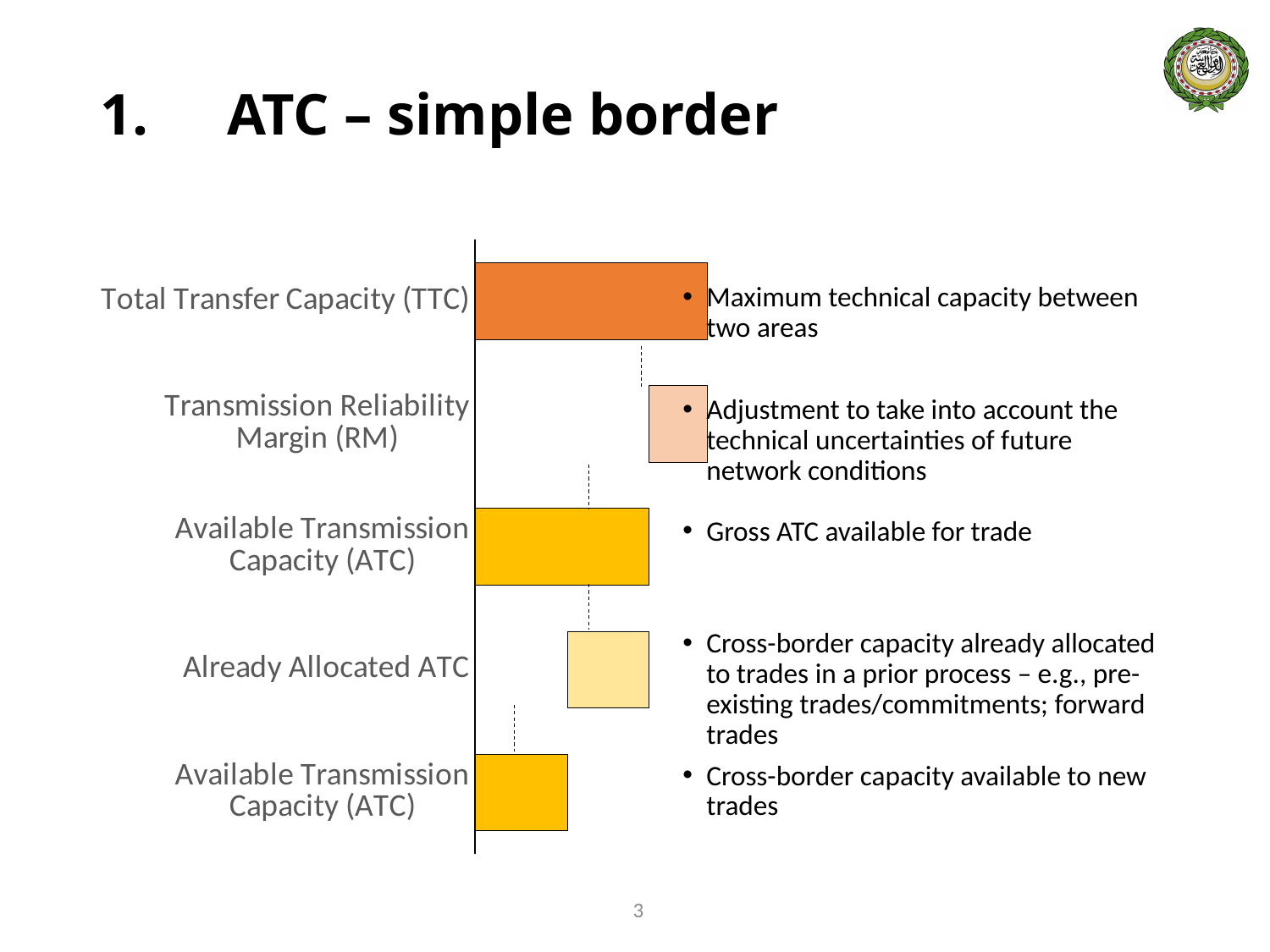
What is the label of the bottom category on the chart? Available Transmission Capacity (ATC) Which bar is longer: Total Transfer Capacity (TTC) or the first Available Transmission Capacity (ATC)? Total Transfer Capacity (TTC) How many categories are plotted on the chart? 5 Which category has the shortest bar on the chart? Transmission Reliability Margin (RM) What kind of chart is shown on the slide? Bar chart Which bar is longer: the first Available Transmission Capacity (ATC) or Already Allocated ATC? Available Transmission Capacity (ATC) Are the bars on the chart drawn horizontally or vertically? Horizontally What is the title of the slide containing the chart? 1. ATC – simple border Which bar is longer: Transmission Reliability Margin (RM) or Already Allocated ATC? Already Allocated ATC Which category has the longest bar on the chart? Total Transfer Capacity (TTC) What is the label of the top category on the chart? Total Transfer Capacity (TTC)